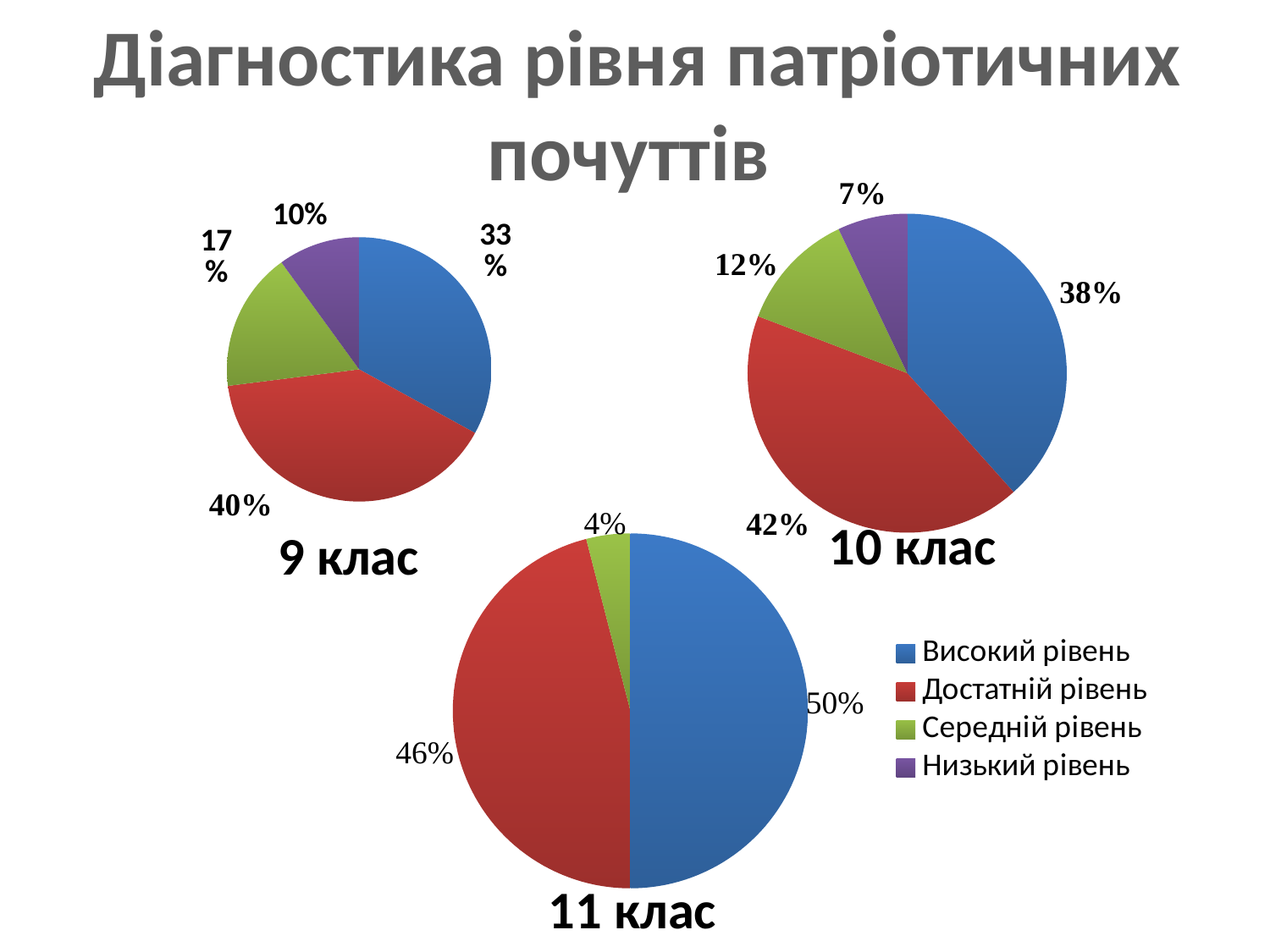
In the "9 клас" pie chart, what share does "Достатній рівень" have? 40% In the "11 клас" pie chart, what share does "Середній рівень" have? 4% How many slices does the "11 клас" pie chart have? 3 In the "9 клас" pie chart, which is larger: the share of "Високий рівень" or the share of "Середній рівень"? Високий рівень How many entries does the legend list? 4 In the "10 клас" pie chart, what share does "Високий рівень" have? 38% In the "10 клас" pie chart, what is the difference between the shares of "Достатній рівень" and "Середній рівень"? 30% In the "11 клас" pie chart, which category has the largest slice? Високий рівень In the "10 клас" pie chart, which category has the largest slice? Достатній рівень What colour represents "Низький рівень" in the pie charts? Purple What kind of chart is used for "11 клас"? Pie chart In the "9 клас" pie chart, which category has the smallest slice? Низький рівень